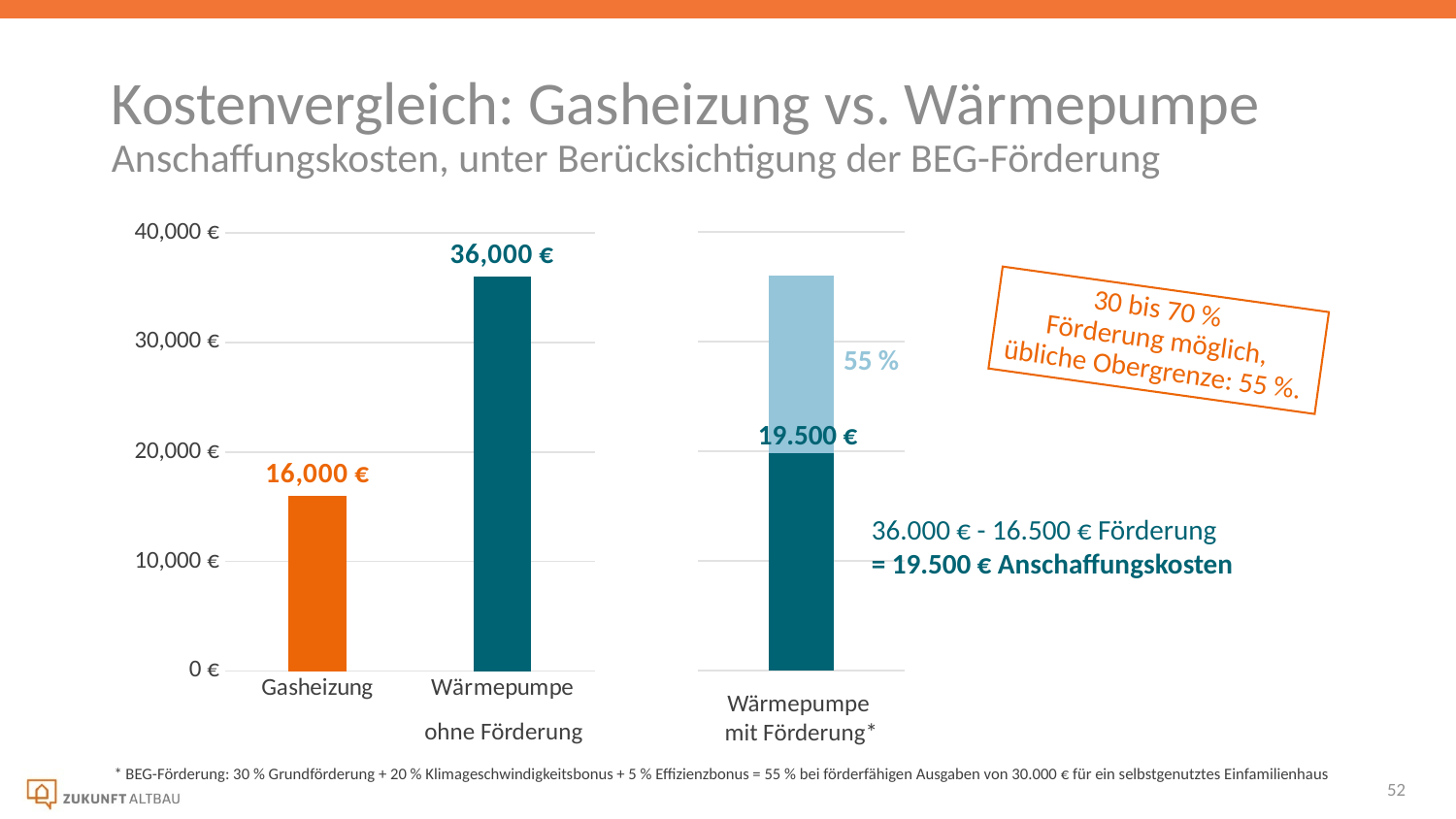
Which category has the highest value in the chart? Wärmepumpe ohne Förderung What is the title of the chart on the slide? Kostenvergleich: Gasheizung vs. Wärmepumpe What is the difference between the Wärmepumpe ohne Förderung value and the Gasheizung value? 20,000 € What is the value shown for Wärmepumpe ohne Förderung? 36,000 € What kind of chart is shown on the slide? bar chart Which category has the lowest value in the chart? Gasheizung How many bars are shown in the chart? 3 What percentage label is shown on the light blue portion of the Wärmepumpe mit Förderung bar? 55 % Is the value for Gasheizung greater or less than 20,000 €? less Which is larger: the value for Gasheizung or the Anschaffungskosten for Wärmepumpe mit Förderung? Wärmepumpe mit Förderung What are the Anschaffungskosten shown for Wärmepumpe mit Förderung? 19.500 € What is the value shown for Gasheizung? 16,000 €